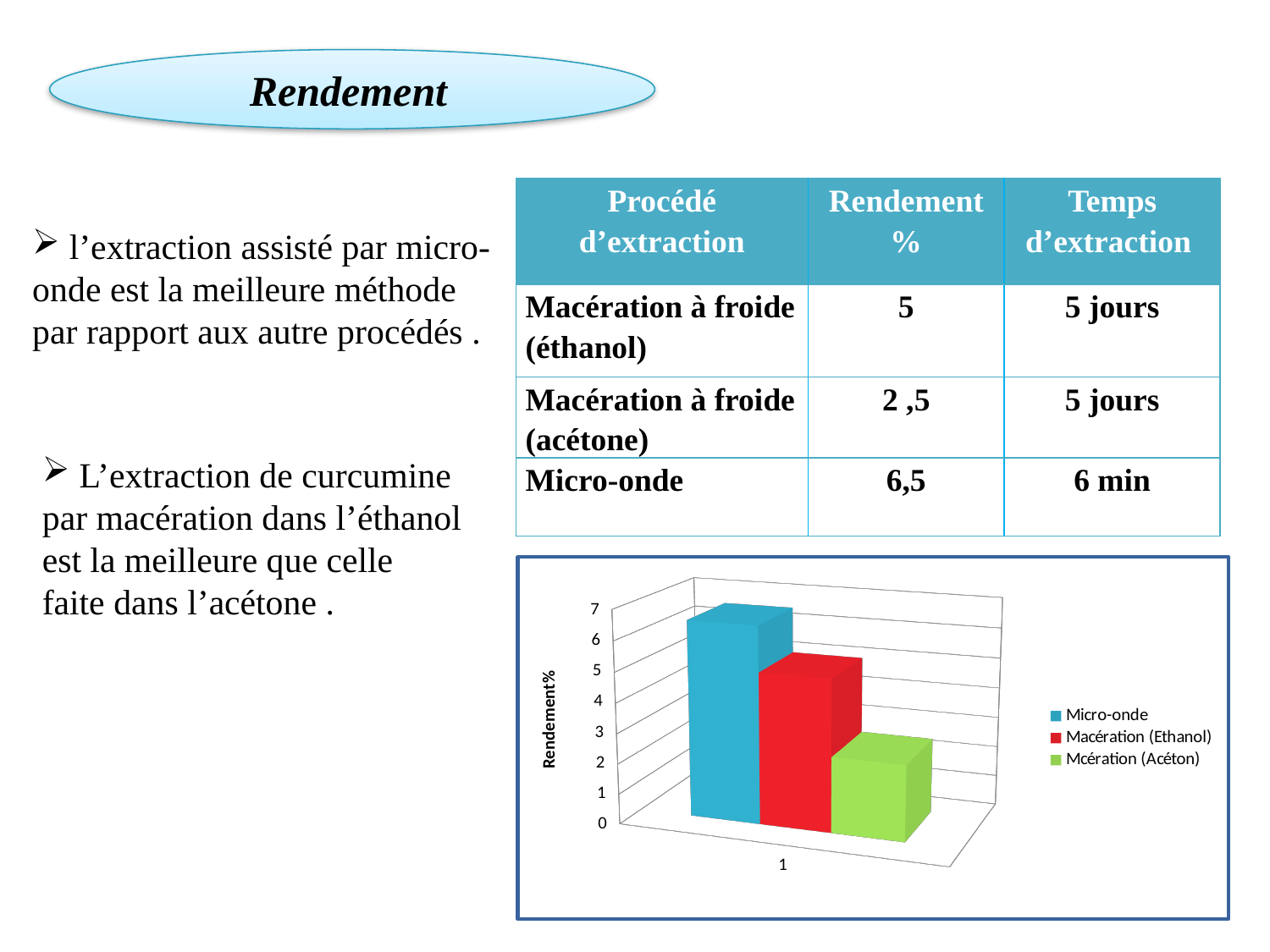
How many series does the chart legend list? 3 Is the value for Mcération (Acéton) in the chart greater or less than 4? less How many categories are shown on the x axis of the chart? 1 Which bar is taller in the chart, Macération (Ethanol) or Mcération (Acéton)? Macération (Ethanol) Is the value for Macération (Ethanol) in the chart greater or less than 3? greater Is the value for Micro-onde in the chart greater or less than 5? greater Which bar is taller in the chart, Micro-onde or Macération (Ethanol)? Micro-onde What colour is the Micro-onde series in the chart? blue Which series has the shortest bar in the chart? Mcération (Acéton) What kind of chart is shown on the slide? bar chart What is the title of the vertical axis of the chart? Rendement% Which series has the tallest bar in the chart? Micro-onde